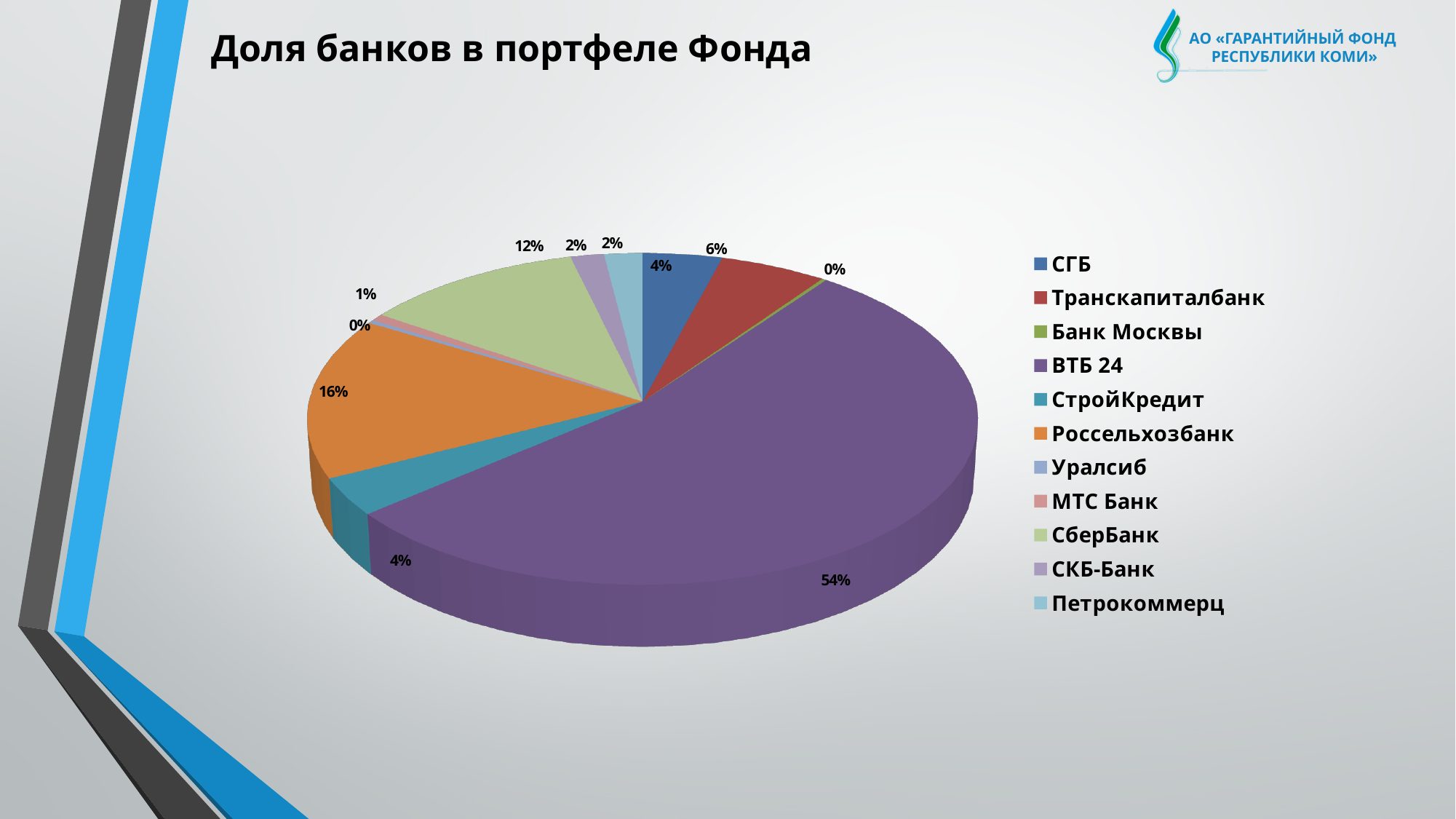
What share of the portfolio does МТС Банк hold? 1% What share of the portfolio does Транскапиталбанк hold? 6% What is the title of the chart? Доля банков в портфеле Фонда What share of the portfolio does ВТБ 24 hold? 54% What share of the portfolio does СберБанк hold? 12% What is the difference between the shares of ВТБ 24 and Россельхозбанк? 38% What share of the portfolio does Россельхозбанк hold? 16% What type of chart is shown on the slide? pie chart What share of the portfolio does СКБ-Банк hold? 2% Which bank has the largest share of the portfolio? ВТБ 24 Which has a larger share, Россельхозбанк or СберБанк? Россельхозбанк How many banks are listed in the legend? 11